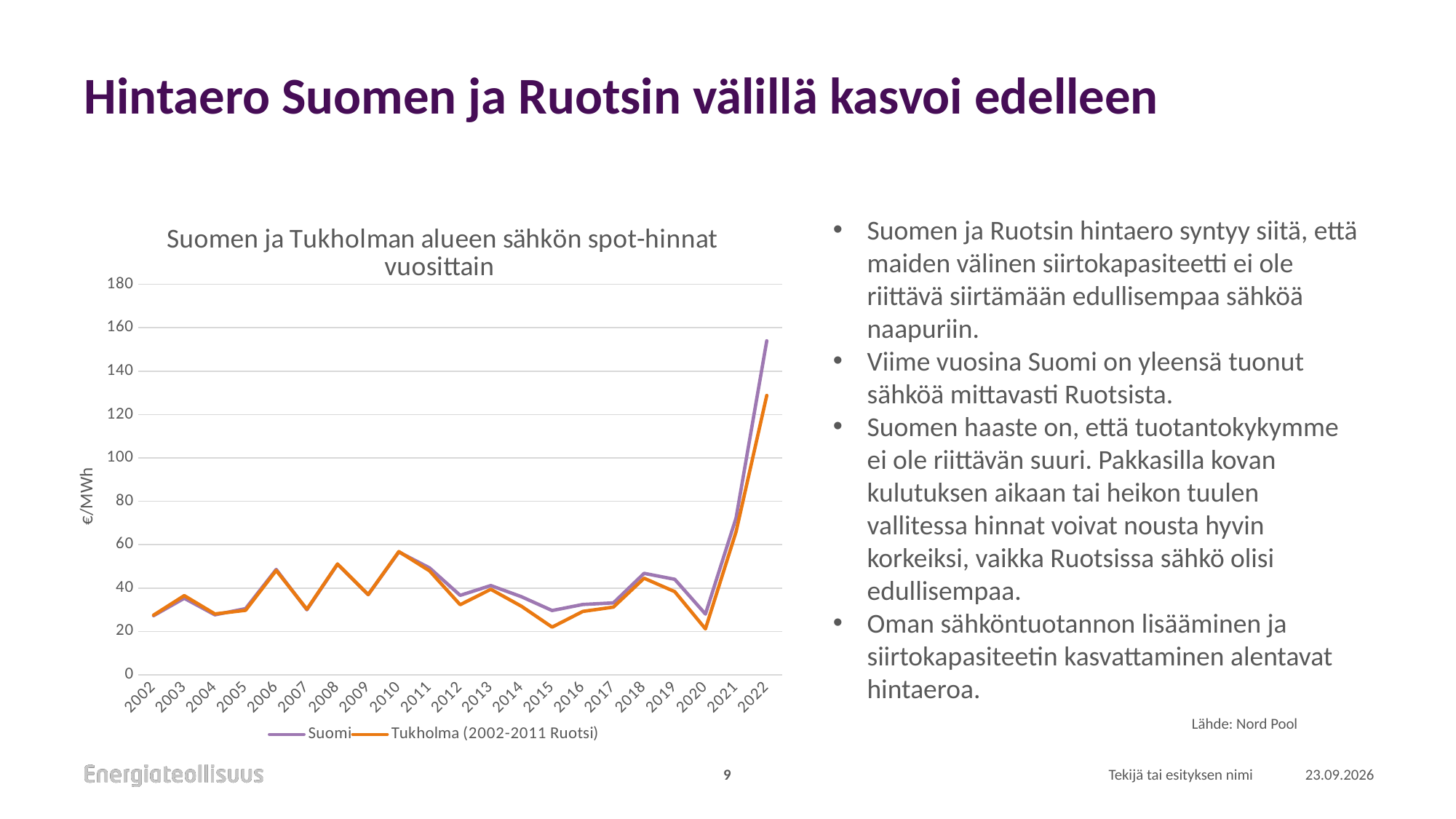
In which year does the Tukholma (2002-2011 Ruotsi) series reach its lowest value? 2020 In which year does the Tukholma (2002-2011 Ruotsi) series reach its highest value? 2022 Is the value for Tukholma (2002-2011 Ruotsi) in 2022 greater or less than 140? less What kind of chart is shown on the slide? line chart Is the value for Tukholma (2002-2011 Ruotsi) in 2020 greater or less than 40? less How many series does the legend of the chart list? 2 What unit is shown on the y axis of the chart? €/MWh Is the value for Suomi in 2022 greater or less than 140? greater How many years are plotted along the x axis of the chart? 21 Which series has the larger value in 2022, Suomi or Tukholma (2002-2011 Ruotsi)? Suomi Do the values of the Suomi series rise or fall from 2020 to 2022? rise In which year does the Suomi series reach its highest value? 2022